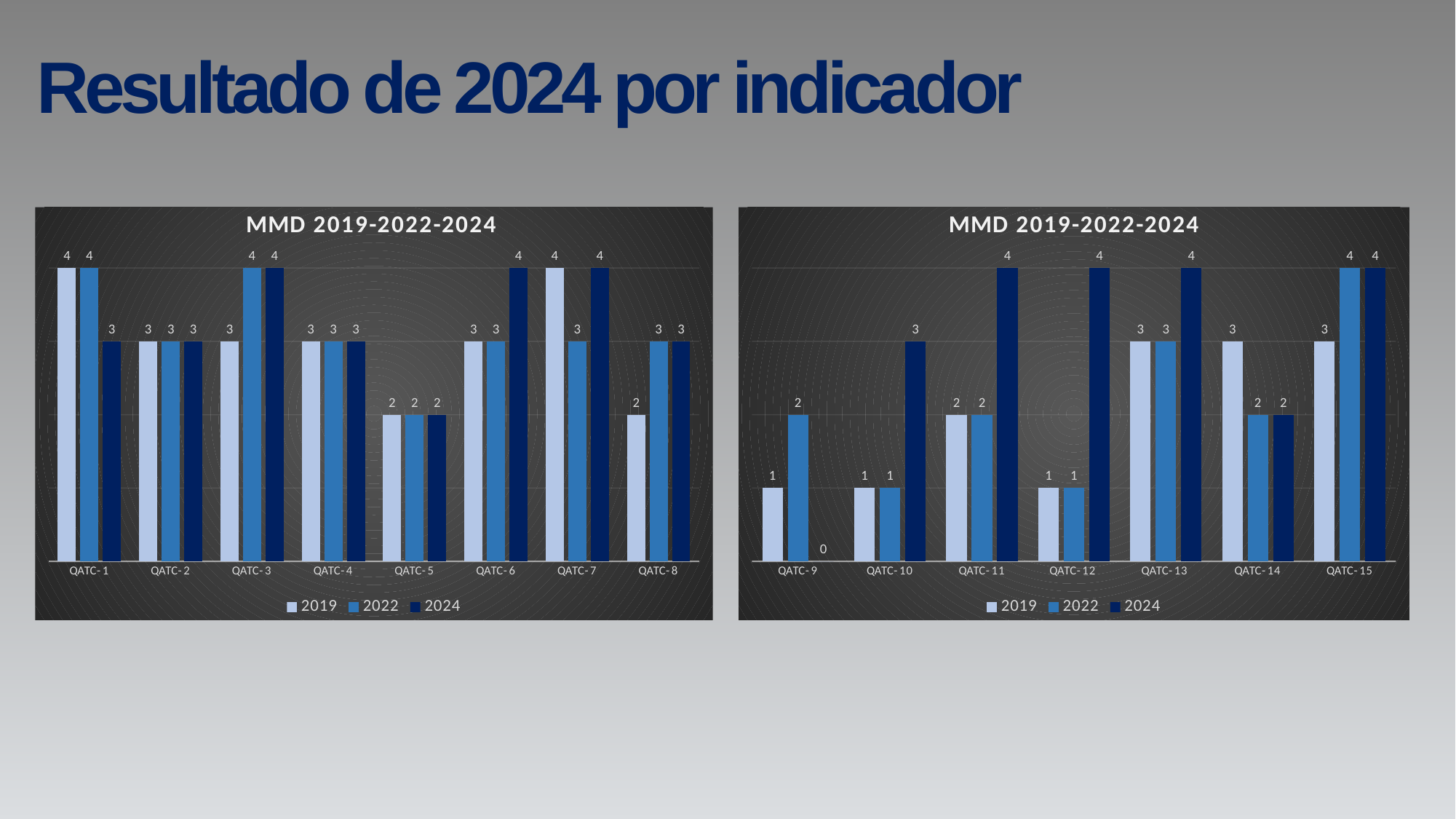
In the right chart, which category has the lowest 2024 value? QATC-9 In the right chart, what is the 2022 value for QATC-15? 4 In the left chart, is the 2019 value for QATC-7 larger or smaller than the 2022 value for QATC-7? larger How many categories are shown on the x axis of the right chart? 7 What type of chart is the left chart? bar chart In the left chart, which category has the lowest 2024 value? QATC-5 What is the title of the right chart? MMD 2019-2022-2024 In the left chart, what is the 2019 value for QATC-8? 2 In the right chart, what is the difference between the 2024 and 2019 values for QATC-12? 3 In the left chart, what is the 2024 value for QATC-1? 3 How many series does the legend of the left chart list? 3 In the right chart, what is the 2024 value for QATC-9? 0